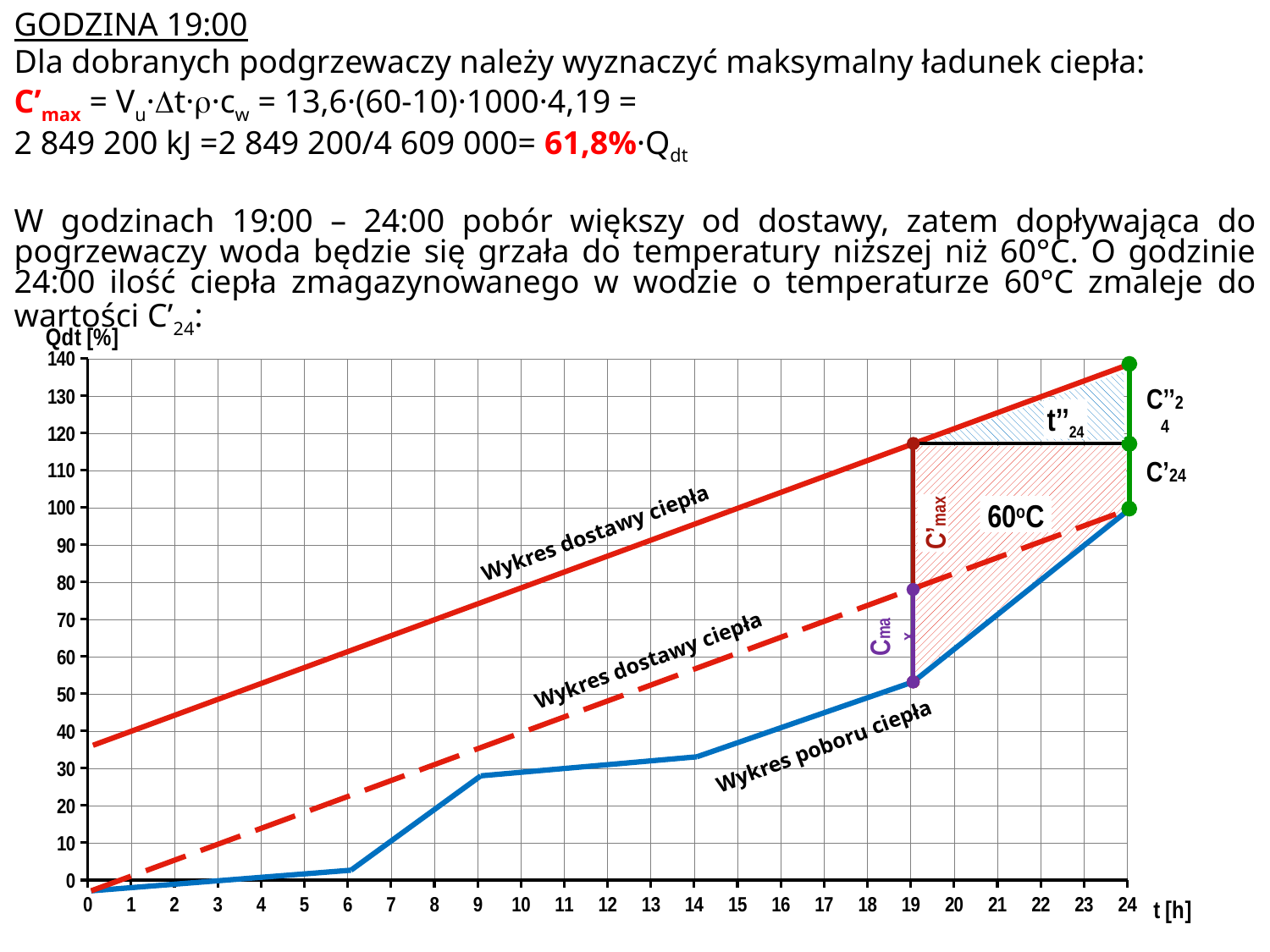
What kind of chart is shown on the slide? line chart Is the value of the solid 'Wykres dostawy ciepła' line at t = 0 h greater or less than 30? greater At t = 14 h, which line is higher: the dashed 'Wykres dostawy ciepła' or 'Wykres poboru ciepła'? Wykres dostawy ciepła (dashed) At t = 19 h, which line is higher: the solid 'Wykres dostawy ciepła' or 'Wykres poboru ciepła'? Wykres dostawy ciepła Is the value of the dashed 'Wykres dostawy ciepła' line at t = 19 h greater or less than 70? greater Is the value of the 'Wykres poboru ciepła' line at t = 6 h greater or less than 10? less What is the label of the horizontal axis of the chart? t [h] What is the label of the vertical axis of the chart? Qdt [%] Does the solid 'Wykres dostawy ciepła' line rise or fall as t increases from 0 to 24 h? rise